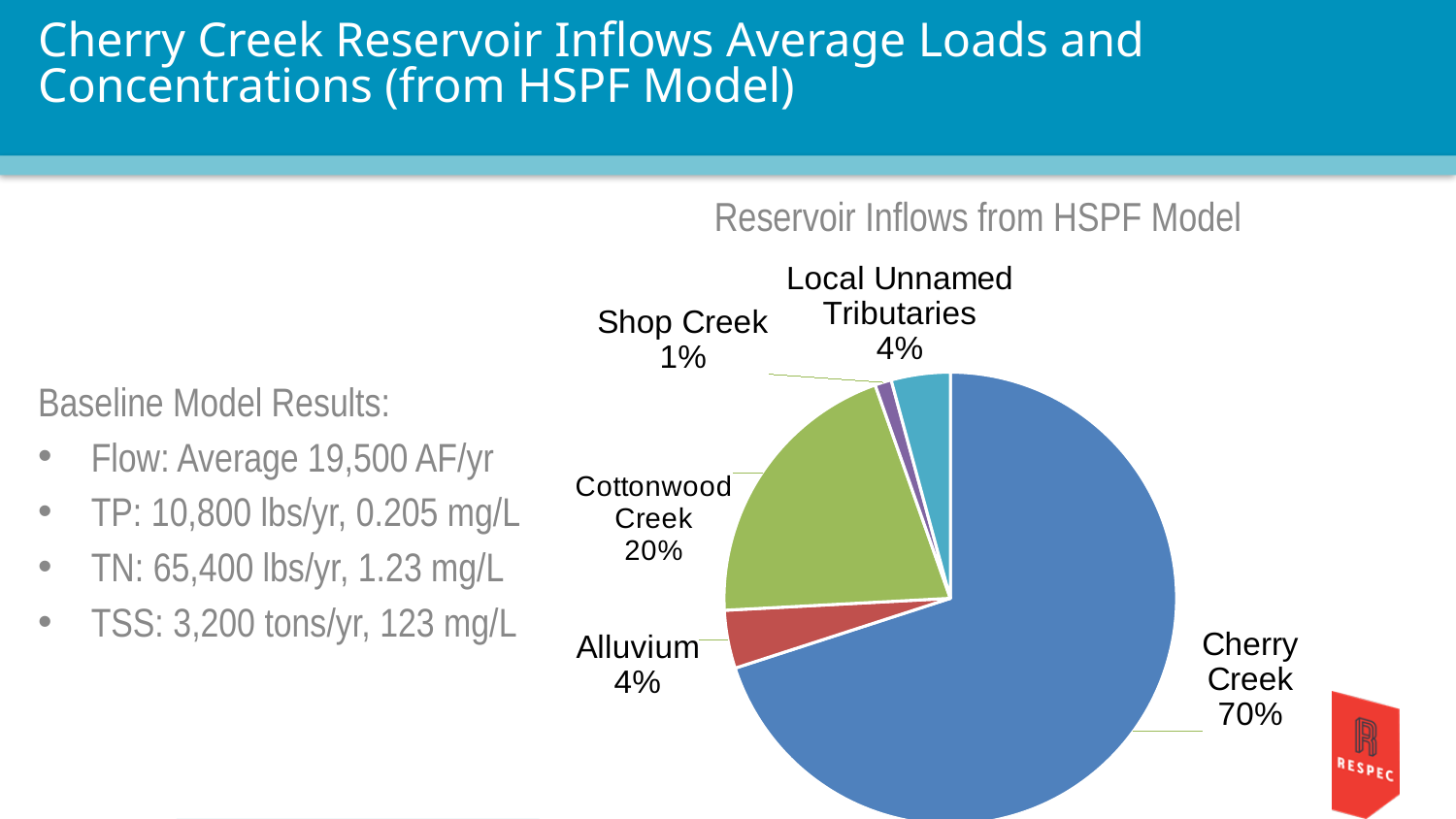
Which has a larger share of inflows, Cottonwood Creek or Alluvium? Cottonwood Creek What type of chart is shown on the slide? Pie chart What is the title of the chart? Reservoir Inflows from HSPF Model What is the difference in percentage points between the Cherry Creek and Cottonwood Creek shares? 50 percentage points How many inflow sources are shown in the pie chart? 5 What share of reservoir inflows comes from Alluvium? 4% Which source contributes the smallest share of reservoir inflows? Shop Creek What share of reservoir inflows comes from Cottonwood Creek? 20% Which source contributes the largest share of reservoir inflows? Cherry Creek What share of reservoir inflows comes from Local Unnamed Tributaries? 4%